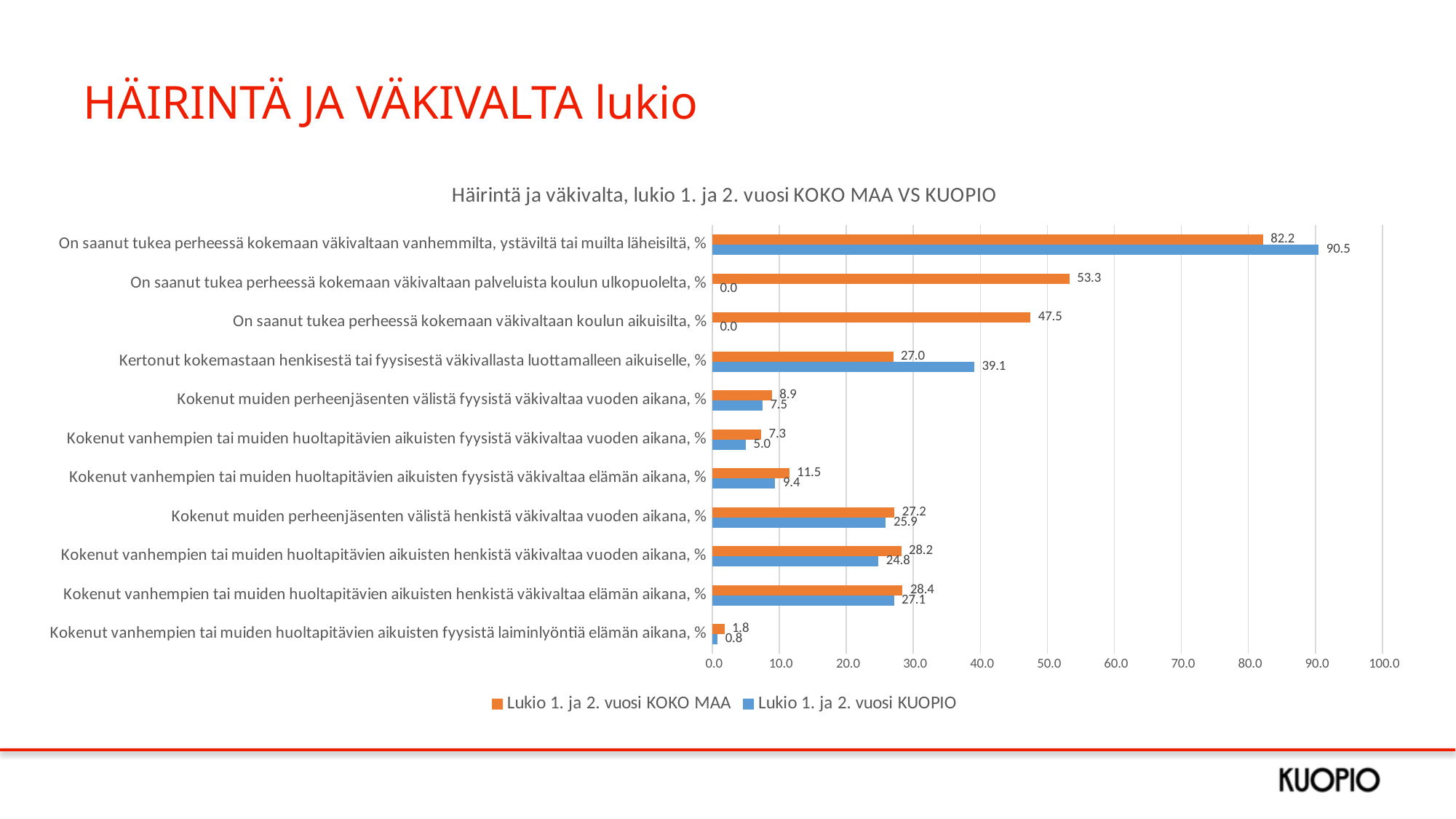
What is the value for 'Lukio 1. ja 2. vuosi KUOPIO' for 'On saanut tukea perheessä kokemaan väkivaltaan vanhemmilta, ystäviltä tai muilta läheisiltä, %'? 90.5 What is the title of the chart? Häirintä ja väkivalta, lukio 1. ja 2. vuosi KOKO MAA VS KUOPIO What kind of chart is shown on the slide? Bar chart What is the value for 'Lukio 1. ja 2. vuosi KUOPIO' for 'Kertonut kokemastaan henkisestä tai fyysisestä väkivallasta luottamalleen aikuiselle, %'? 39.1 How many categories are shown on the chart? 11 Is the KOKO MAA value for 'On saanut tukea perheessä kokemaan väkivaltaan koulun aikuisilta, %' greater or less than 40.0? greater Which category has the highest value for 'Lukio 1. ja 2. vuosi KOKO MAA'? On saanut tukea perheessä kokemaan väkivaltaan vanhemmilta, ystäviltä tai muilta läheisiltä, % What is the value for 'Lukio 1. ja 2. vuosi KOKO MAA' for 'On saanut tukea perheessä kokemaan väkivaltaan palveluista koulun ulkopuolelta, %'? 53.3 What is the difference between the KOKO MAA and KUOPIO values for 'Kokenut vanhempien tai muiden huoltapitävien aikuisten henkistä väkivaltaa vuoden aikana, %'? 3.4 Which category has the lowest value for 'Lukio 1. ja 2. vuosi KOKO MAA'? Kokenut vanhempien tai muiden huoltapitävien aikuisten fyysistä laiminlyöntiä elämän aikana, % How many series does the legend list? 2 For 'Kertonut kokemastaan henkisestä tai fyysisestä väkivallasta luottamalleen aikuiselle, %', which series has the larger value, KOKO MAA or KUOPIO? Lukio 1. ja 2. vuosi KUOPIO